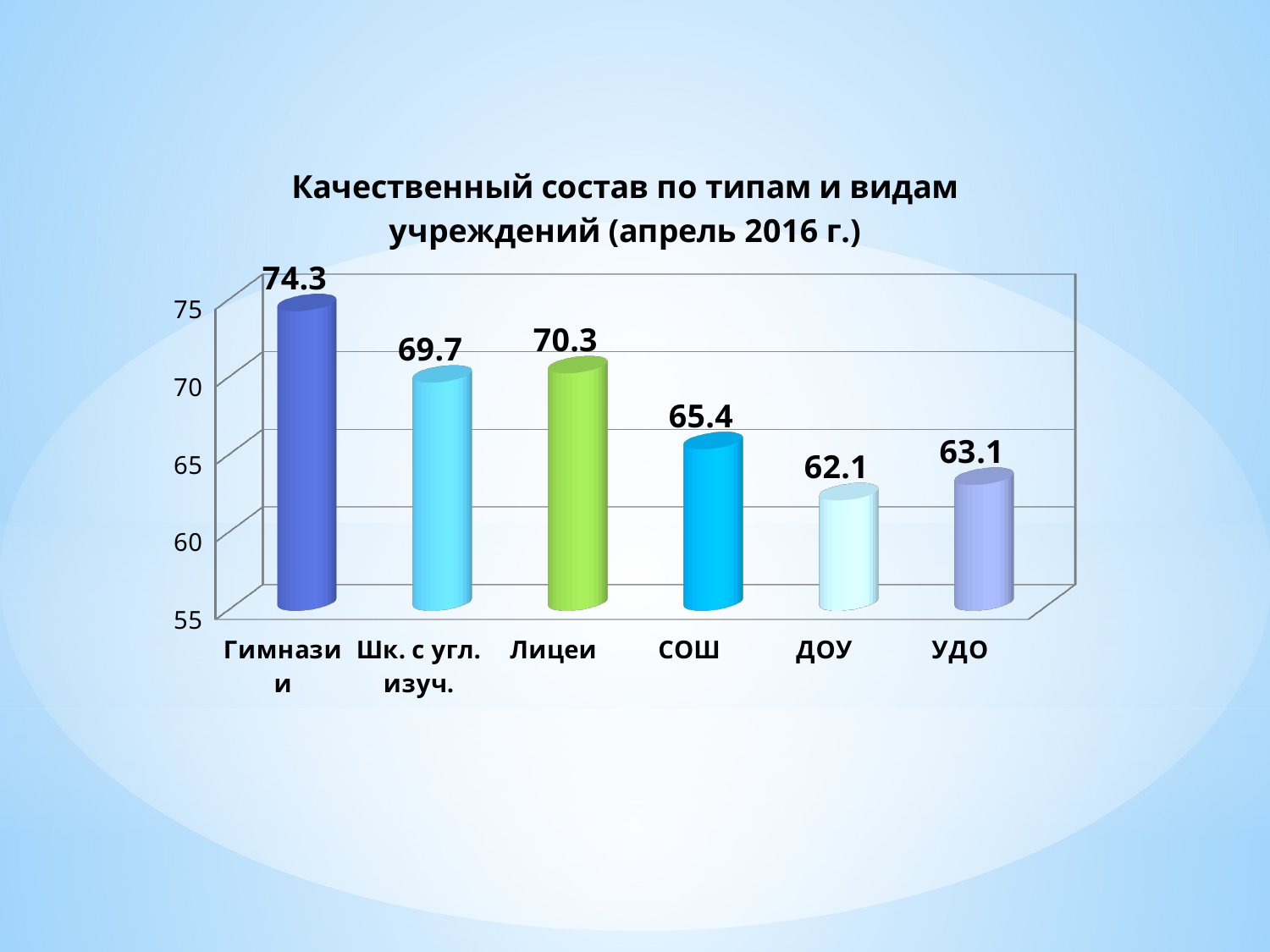
Which is larger, the value for Лицеи or the value for Шк. с угл. изуч.? Лицеи Which category has the highest value? Гимназии What is the difference between the values for Гимназии and СОШ? 8.9 Which category has the lowest value? ДОУ What is the value for Лицеи? 70.3 What is the title of the chart? Качественный состав по типам и видам учреждений (апрель 2016 г.) What is the value for УДО? 63.1 What is the value for Гимназии? 74.3 What kind of chart is shown on the slide? bar chart What is the value for ДОУ? 62.1 Is the value for СОШ greater or less than 70? less How many categories are shown in the chart? 6